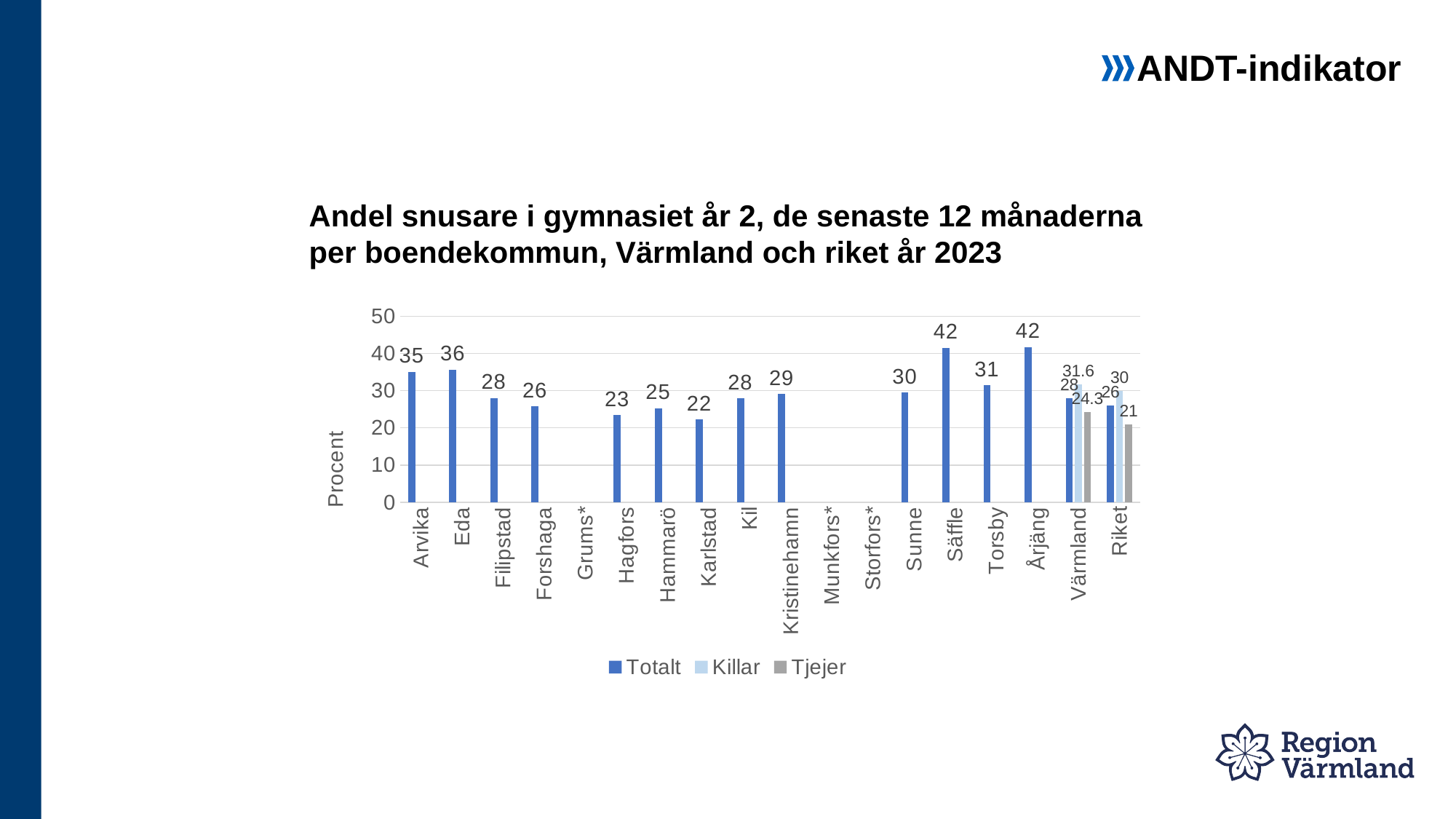
How many categories are shown on the x axis? 18 What is the Totalt value for Arvika? 35 What is the Tjejer value for Riket? 21 What is the Killar value for Värmland? 31.6 What is the label of the y axis? Procent What is the difference between the Killar and Tjejer values for Värmland? 7.3 What kind of chart is shown on the slide? Bar chart How many series does the legend list? 3 Is the Totalt value for Säffle greater or less than 40? greater What is the difference between the Totalt values for Eda and Hagfors? 13 Which has a higher Totalt value, Torsby or Sunne? Torsby Which municipality has the lowest Totalt value among those with a bar shown? Karlstad